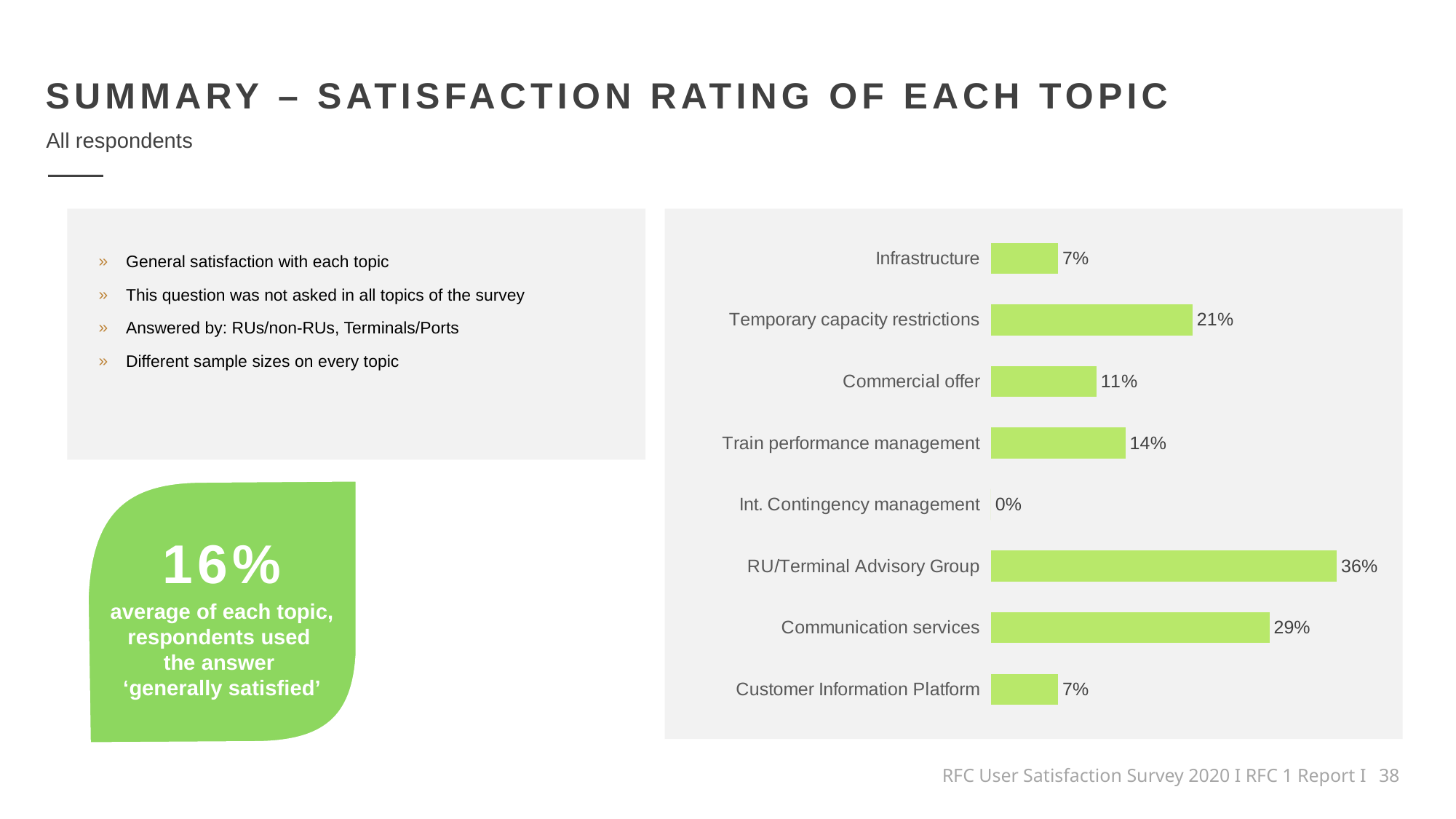
What is the difference between the values for RU/Terminal Advisory Group and Communication services? 7% What is the value for Train performance management? 14% What is the value for Communication services? 29% How many categories are shown in the chart? 8 What is the difference between the values for Temporary capacity restrictions and Commercial offer? 10% Which category has the lowest value? Int. Contingency management Which two categories share the same value of 7%? Infrastructure and Customer Information Platform What is the value for Temporary capacity restrictions? 21% Which category has the highest value? RU/Terminal Advisory Group What is the value for Int. Contingency management? 0% Which is larger, the value for Commercial offer or the value for Train performance management? Train performance management What kind of chart is shown on the slide? Bar chart